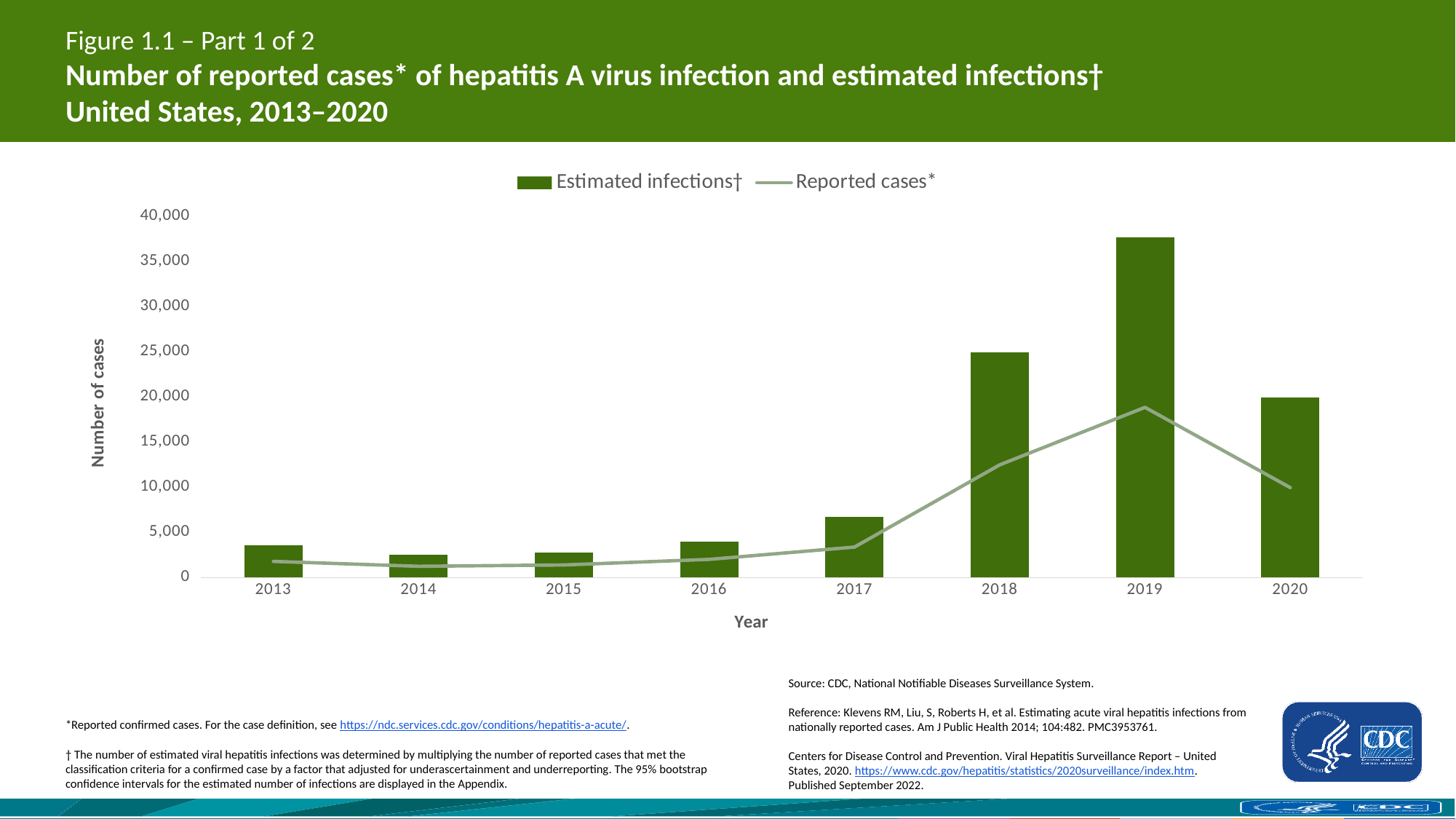
Do the estimated infections rise or fall from 2017 to 2019? rise Which year has the highest number of reported cases? 2019 How many series does the legend list? 2 What is the title of the y axis? Number of cases Which is larger, the estimated infections in 2019 or in 2020? 2019 Is the value for estimated infections in 2013 greater or less than 5,000? less What kind of chart is shown on the slide? A combined bar and line chart How many years are shown on the x axis? 8 Is the value for estimated infections in 2019 greater or less than 35,000? greater Is the value for reported cases in 2019 greater or less than 15,000? greater Which year has the highest number of estimated infections? 2019